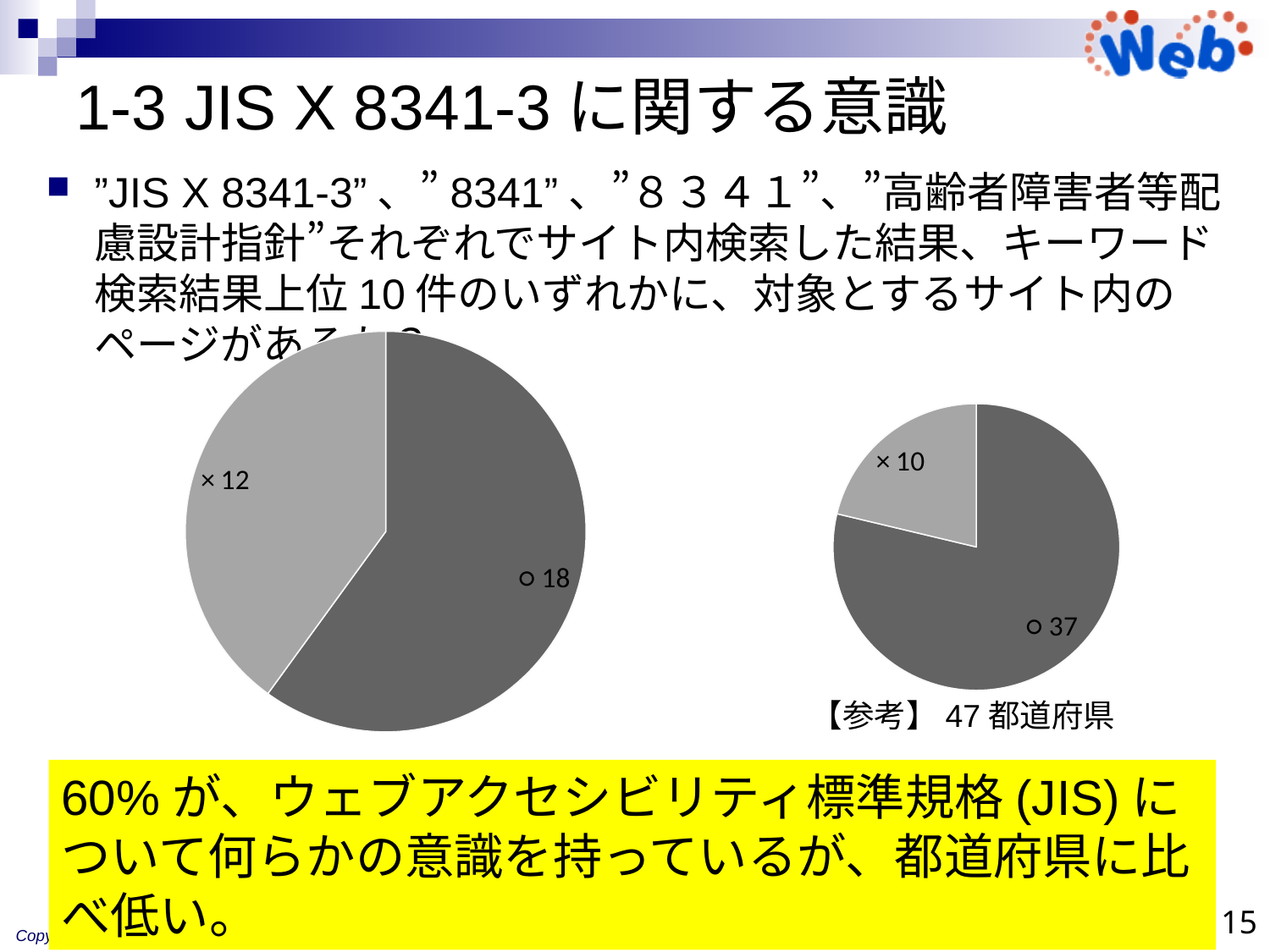
In the right pie chart (【参考】47都道府県), what is the value for the × slice? 10 In the left pie chart, what is the difference between the ○ value and the × value? 6 In the right pie chart (【参考】47都道府県), what is the value for the ○ slice? 37 In the right pie chart, which slice is the smallest? × In the left pie chart, what is the value for the × slice? 12 In the left pie chart, what is the value for the ○ slice? 18 What is the total of the two slices in the left pie chart? 30 How many slices does the left pie chart have? 2 In the right pie chart, what is the difference between the ○ value and the × value? 27 What type of chart is the left chart on the slide? pie chart In the left pie chart, what share of the total does the ○ slice represent? 60% In the left pie chart, which slice is larger, ○ or ×? ○